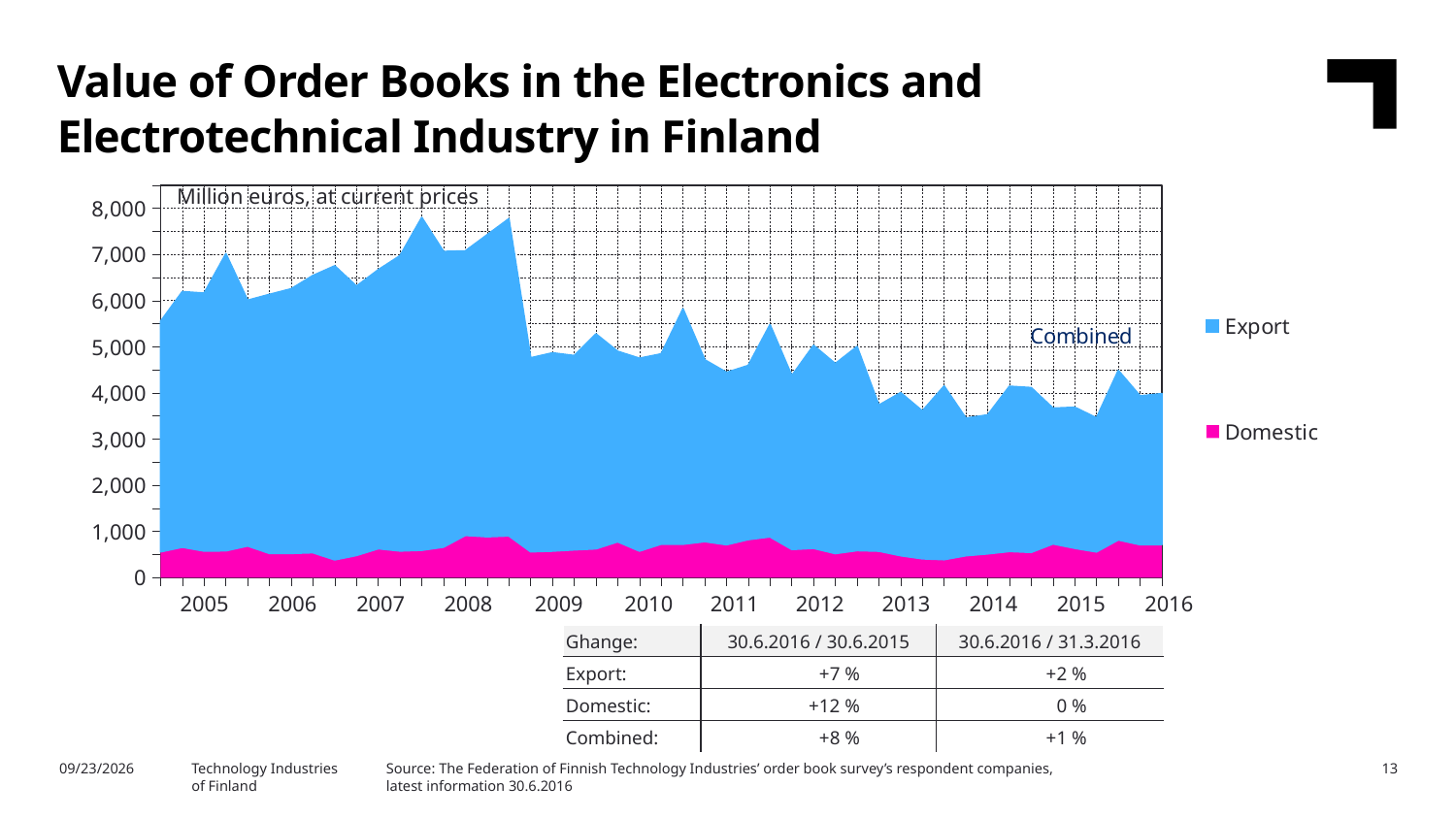
What are the two series named in the legend? Export and Domestic Is the combined value at its 2008 peak greater or less than 7,000? greater Is the combined value in 2012 greater or less than 4,000? greater What unit is stated at the top of the chart? Million euros, at current prices How many years are labelled on the x axis? 12 Do the combined values generally rise or fall from 2008 to 2016? Fall Which is larger, the combined value in 2008 or in 2014? 2008 How many series does the legend list? 2 Is the combined value in 2010 greater or less than 6,000? less What kind of chart is shown on the slide? Area chart